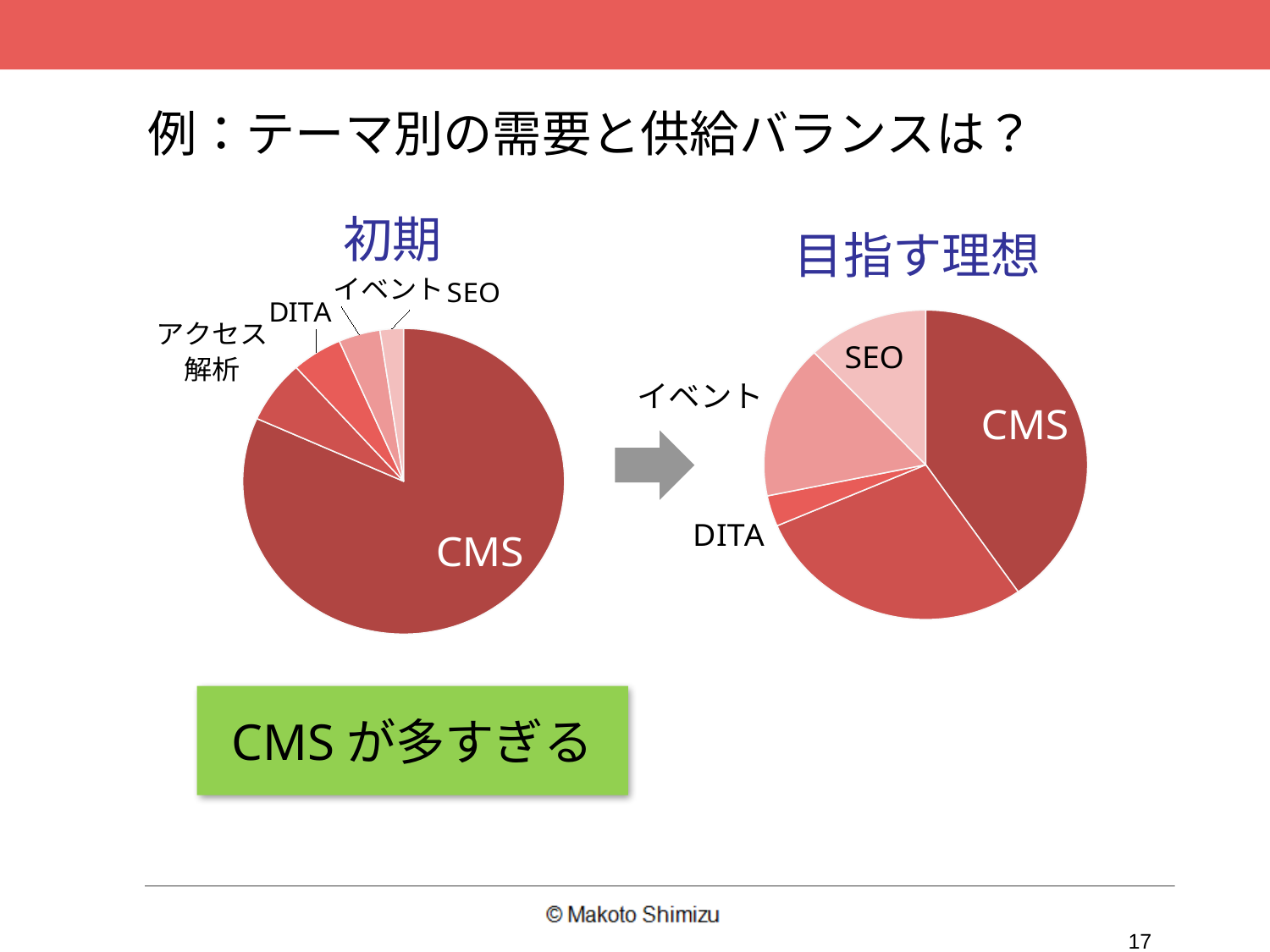
What is the title of the pie chart on the right? 目指す理想 How many pie charts are shown on the slide? 2 What kind of chart is the "初期" chart on the left? pie chart In the "初期" pie chart, which slice is larger, CMS or DITA? CMS In the "初期" pie chart, which labeled category has the smallest slice? SEO In the "初期" pie chart, how many labeled categories are there? 5 What kind of chart is the "目指す理想" chart on the right? pie chart In the "初期" pie chart, which slice is larger, アクセス解析 or イベント? アクセス解析 In the "目指す理想" pie chart, which slice is larger, SEO or DITA? SEO In the "初期" pie chart, which category has the largest slice? CMS In the "目指す理想" pie chart, which labeled category has the smallest slice? DITA